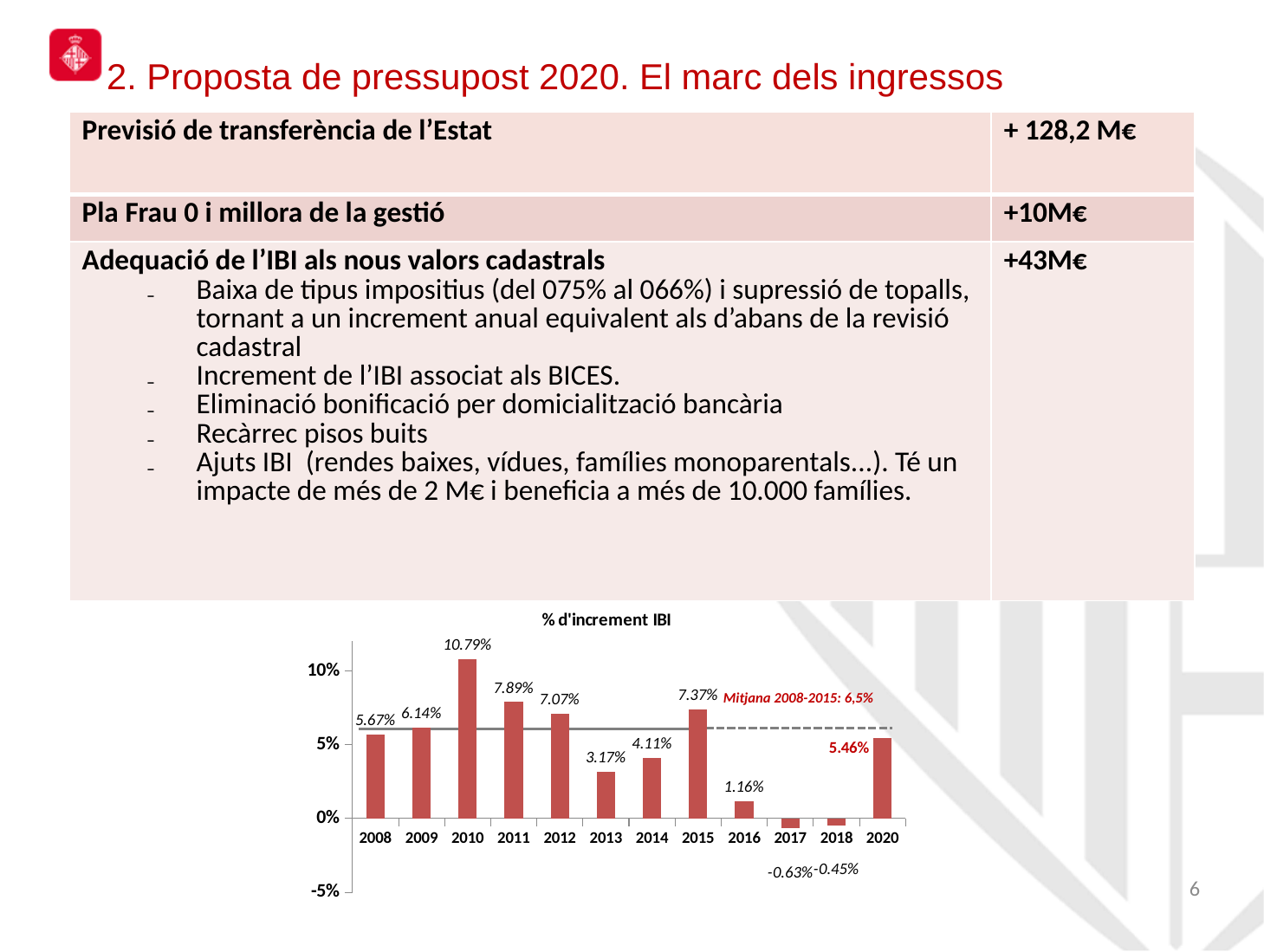
Which year has the highest value in the chart? 2010 What is the value for 2020 in the chart? 5.46% Is the value for 2013 greater or less than 5%? less What is the value for 2010 in the chart? 10.79% What is the difference between the values for 2010 and 2020? 5.33% What is the value for 2017 in the chart? -0.63% Which is larger, the value for 2011 or the value for 2012? 2011 Which year has the lowest value in the chart? 2017 What type of chart is shown on the slide? bar chart How many years are plotted in the chart? 12 What is the title of the chart? % d'increment IBI What average for 2008-2015 is annotated on the chart? 6,5%